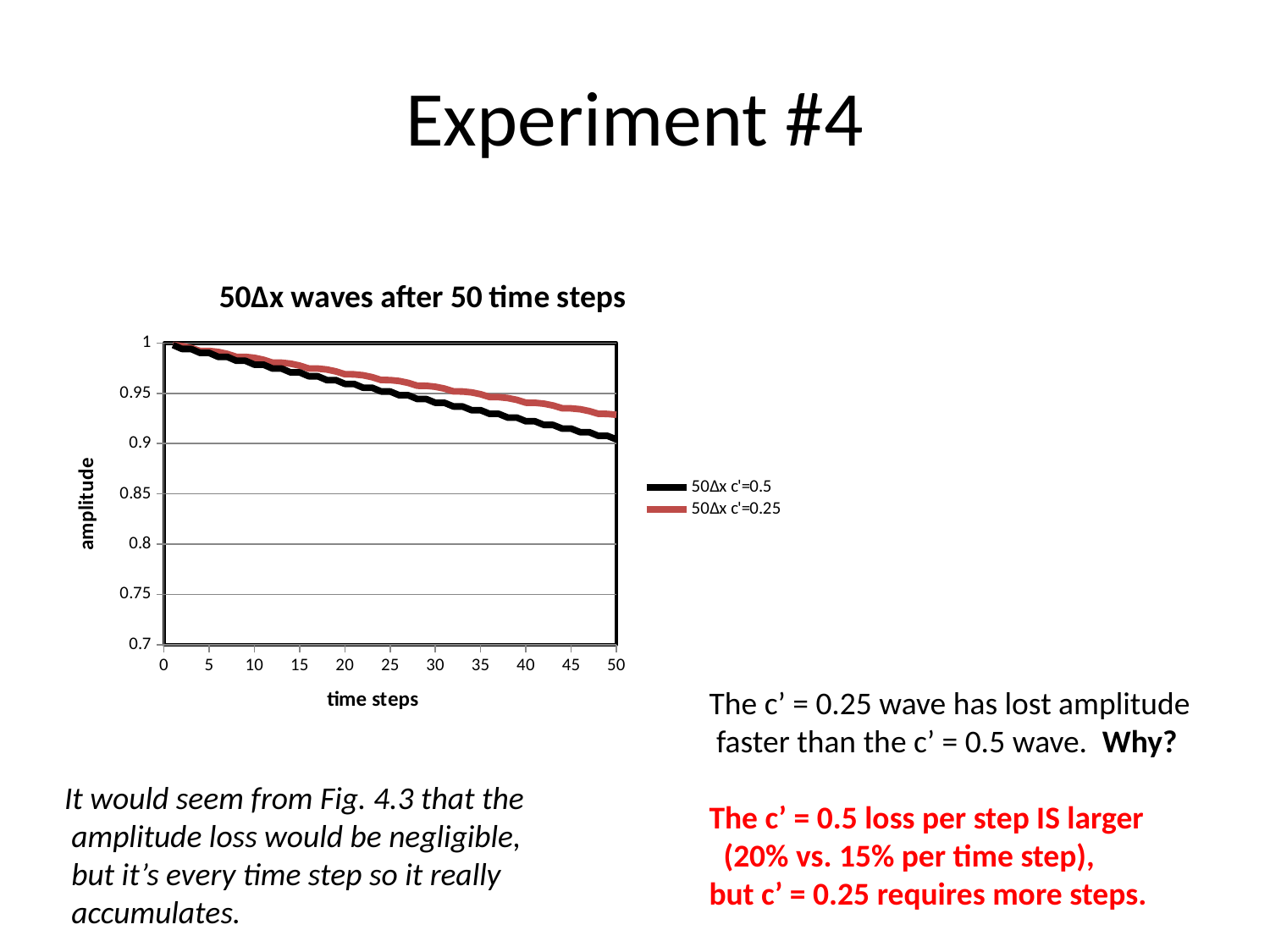
What kind of chart is shown on the slide? line chart How many series does the chart's legend list? 2 Do the amplitude values rise or fall as the time steps increase? fall Is the amplitude of the 50Δx c'=0.5 series at time step 40 greater or less than 0.95? less What are the two series named in the legend? 50Δx c'=0.5 and 50Δx c'=0.25 At time step 50, which series has the higher amplitude, 50Δx c'=0.5 or 50Δx c'=0.25? 50Δx c'=0.25 What is the title of the chart? 50Δx waves after 50 time steps Is the amplitude of the 50Δx c'=0.25 series at time step 25 greater or less than 0.95? greater Is the amplitude of the 50Δx c'=0.25 series at time step 50 greater or less than 0.9? greater Which series shows the lowest amplitude at the end of the 50 time steps? 50Δx c'=0.5